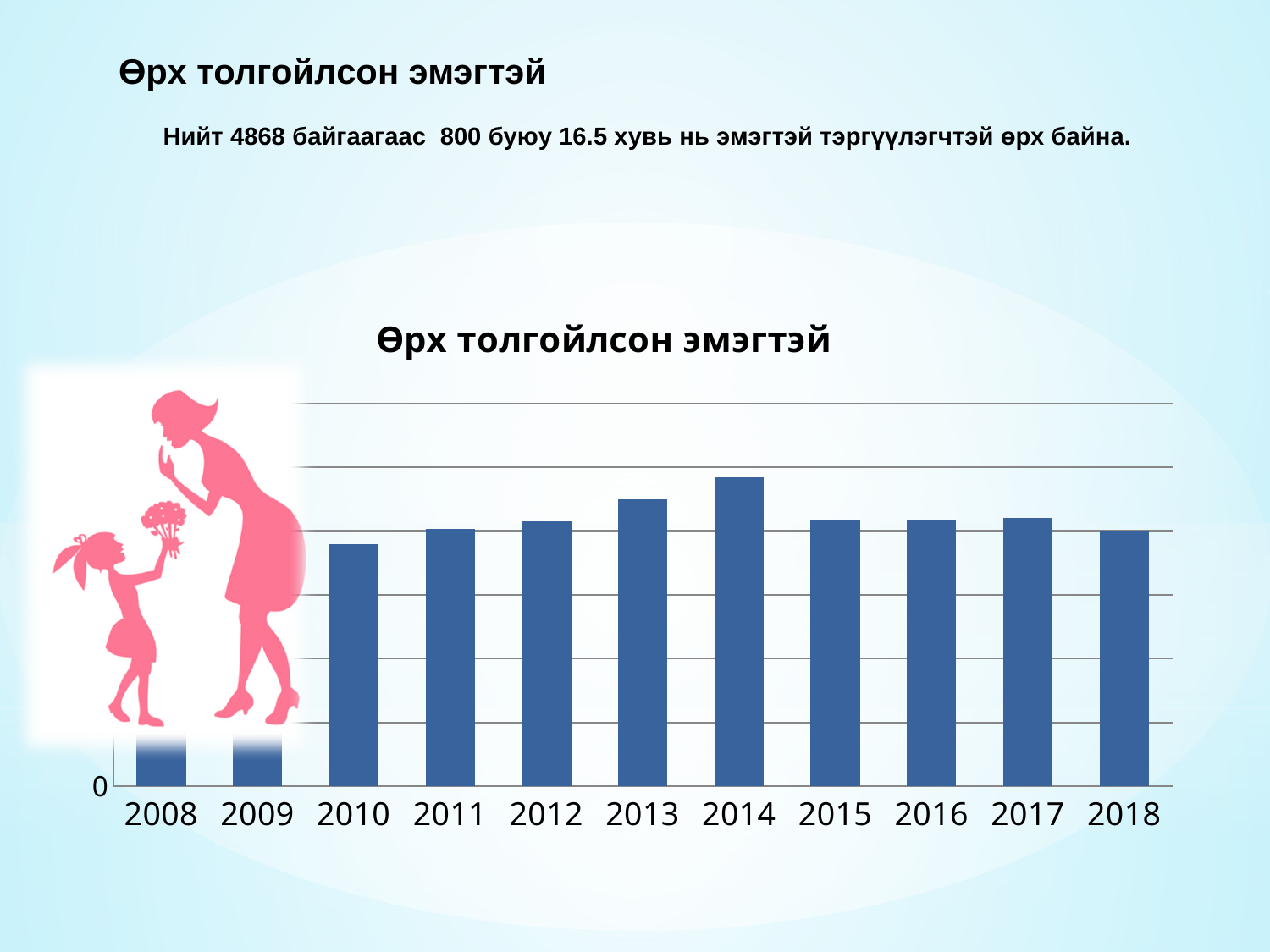
What kind of chart is shown on the slide? bar chart How many years are shown on the x axis of the chart? 11 Among the years 2010 to 2018, which year has the lowest bar? 2010 Which year is the first category on the x axis? 2008 Among the years 2010 to 2018, which year has the highest bar? 2014 Which is larger, the value for 2014 or the value for 2010? 2014 Which is larger, the value for 2011 or the value for 2010? 2011 What is the title of the chart? Өрх толгойлсон эмэгтэй Do the values rise or fall from 2014 to 2018? fall Which is larger, the value for 2013 or the value for 2018? 2013 Do the values rise or fall from 2010 to 2014? rise